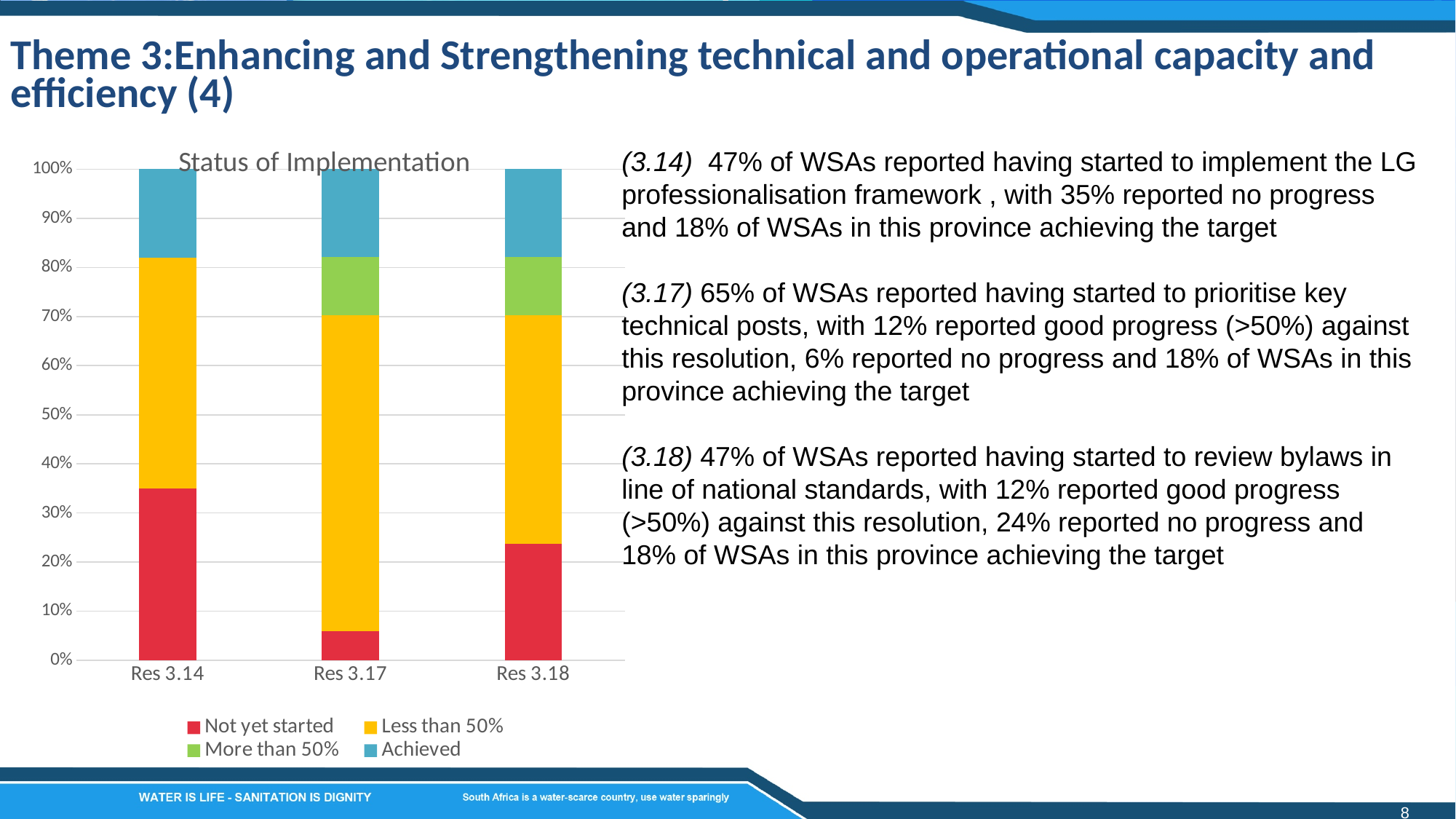
Which category has the smallest 'Not yet started' segment? Res 3.17 What is the title of the chart? Status of Implementation What is the total height of the stacked bar for Res 3.17? 100% Is the 'Not yet started' value for Res 3.17 greater or less than 10%? less Which category has no 'More than 50%' segment in its bar? Res 3.14 Which colour represents the 'Achieved' series in the chart? Blue Is the 'Not yet started' value for Res 3.18 greater or less than 30%? less Is the 'Not yet started' value for Res 3.14 greater or less than 30%? greater How many categories are shown on the x axis of the chart? 3 How many series does the chart legend list? 4 What kind of chart is shown on the slide? Stacked bar chart Which category has the largest 'Not yet started' segment? Res 3.14